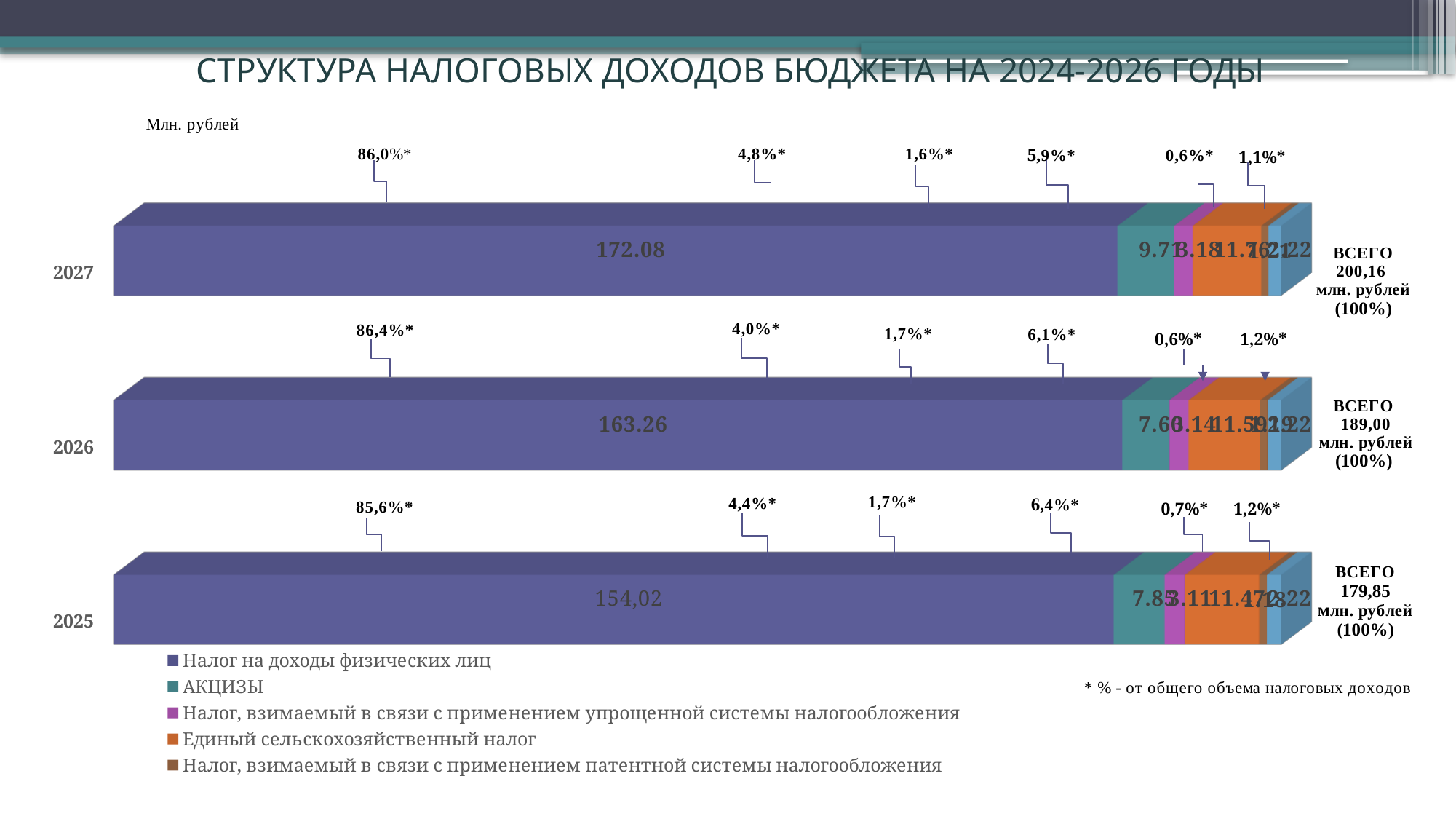
What kind of chart is shown on the slide? Stacked bar chart What is the value of 'Налог на доходы физических лиц' for 2027? 172.08 What is the value of 'Налог на доходы физических лиц' for 2025? 154,02 Which year has the highest total (ВСЕГО) tax revenue? 2027 What share of total tax revenue does 'Налог на доходы физических лиц' make up in 2026? 86,4% How many series does the legend list? 5 What share of total tax revenue do 'АКЦИЗЫ' make up in 2025? 4,4% What is the difference between the total for 2027 (200,16) and the total for 2025 (179,85)? 20,31 What is the total (ВСЕГО) for 2027 in million rubles? 200,16 What is the value of 'Налог на доходы физических лиц' for 2026? 163.26 How many years (bars) are shown in the chart? 3 Which year has the larger value for 'Налог на доходы физических лиц', 2027 or 2025? 2027